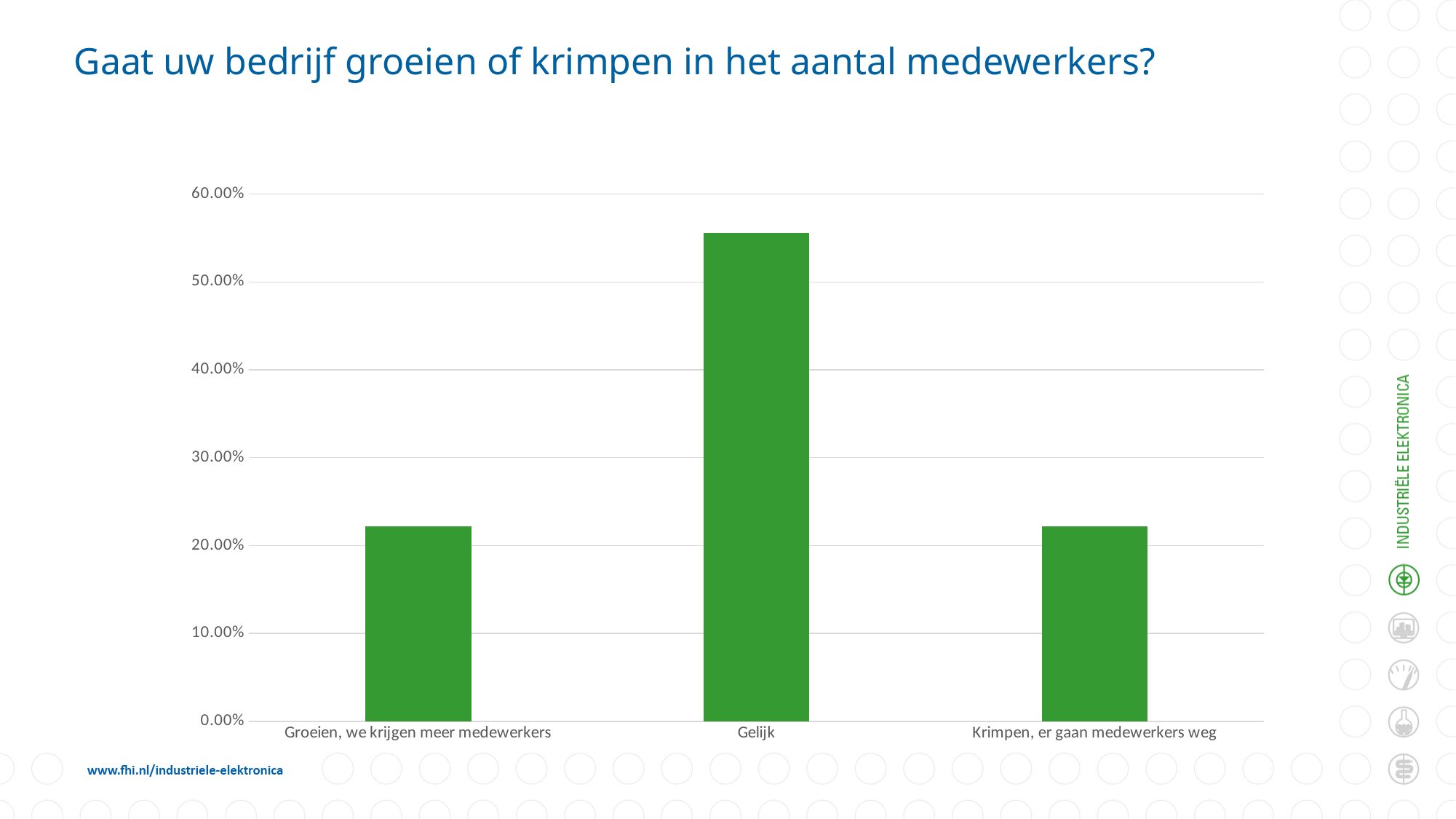
Which is larger: the value for Gelijk or the value for 'Krimpen, er gaan medewerkers weg'? Gelijk Is the value for Gelijk greater or less than 50.00%? greater Is the value for 'Krimpen, er gaan medewerkers weg' greater or less than 20.00%? greater What is the title of the slide containing the chart? Gaat uw bedrijf groeien of krimpen in het aantal medewerkers? Is the value for Gelijk greater or less than 60.00%? less What kind of chart is shown on the slide? bar chart What colour are the bars in the chart? green Which category has the highest value in the chart? Gelijk How many categories are shown on the x axis of the chart? 3